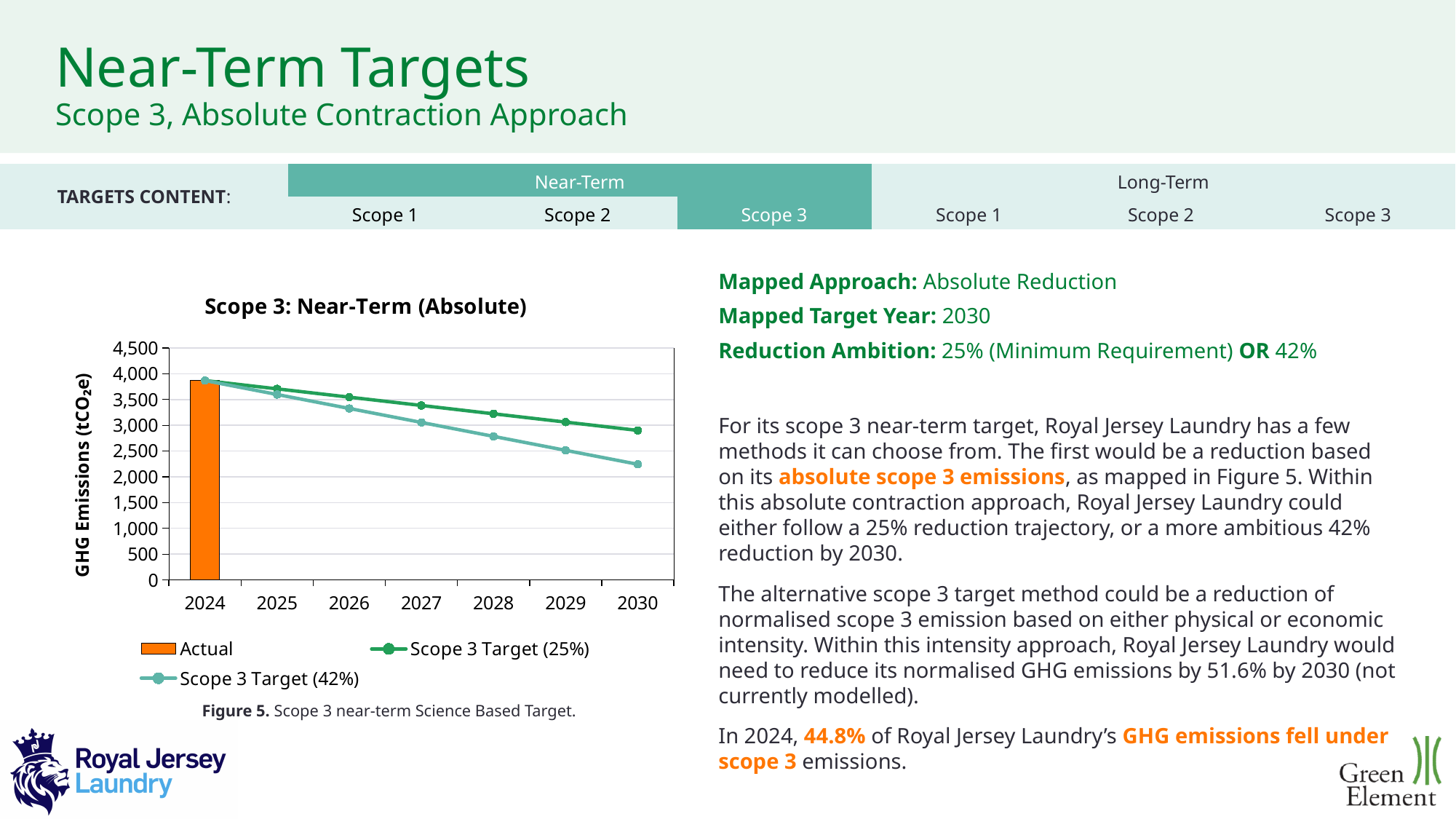
Which year has the only bar in the Actual series? 2024 In 2030, which series is higher: Scope 3 Target (25%) or Scope 3 Target (42%)? Scope 3 Target (25%) What kind of chart is shown on the slide? A combined bar and line chart Is the Scope 3 Target (42%) value for 2030 greater or less than 2,000? greater What is the title of the chart on the slide? Scope 3: Near-Term (Absolute) How many years are shown on the x axis of the chart? 7 Do the Scope 3 Target (25%) values rise or fall from 2024 to 2030? fall Is the Scope 3 Target (25%) value for 2030 greater or less than 3,000? less What is the label of the y axis of the chart? GHG Emissions (tCO₂e) How many series does the chart legend list? 3 Is the Actual value for 2024 greater or less than 3,500? greater